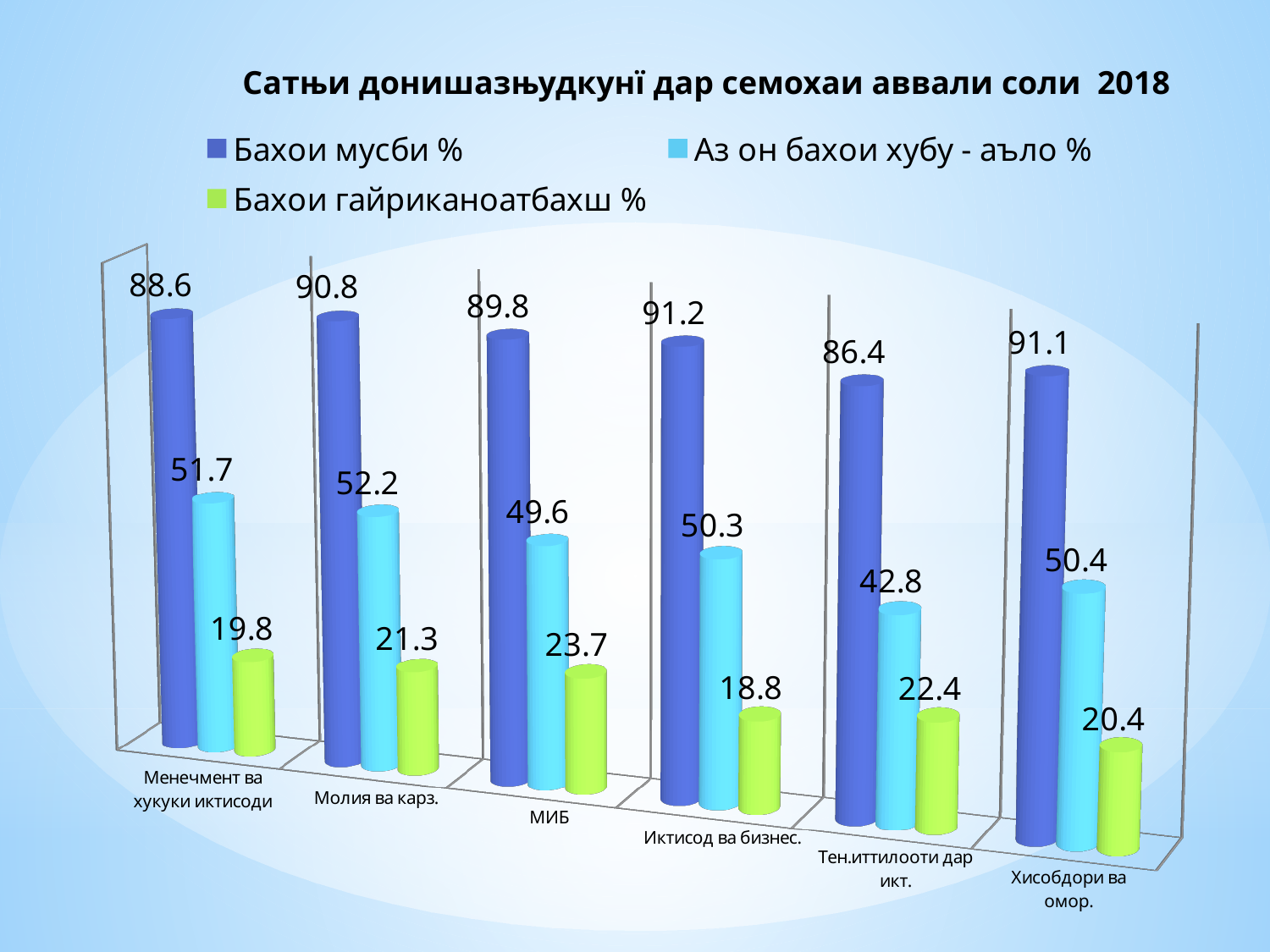
Which is larger: Бахои мусби % for Молия ва карз. or for Тен.иттилооти дар икт.? Молия ва карз. Which category has the highest value for Бахои гайриканоатбахш %? МИБ What is the value of Бахои гайриканоатбахш % for МИБ? 23.7 How many categories are shown on the x axis? 6 What is the value of Бахои мусби % for Менечмент ва хукуки иктисоди? 88.6 What is the value of Аз он бахои хубу - аъло % for Иктисод ва бизнес.? 50.3 What kind of chart is shown on the slide? Bar chart What is the difference between Бахои мусби % and Аз он бахои хубу - аъло % for Менечмент ва хукуки иктисоди? 36.9 Which category has the lowest value for Аз он бахои хубу - аъло %? Тен.иттилооти дар икт. Which category has the lowest value for Бахои мусби %? Тен.иттилооти дар икт. How many series does the legend list? 3 What is the value of Бахои мусби % for Хисобдори ва омор.? 91.1